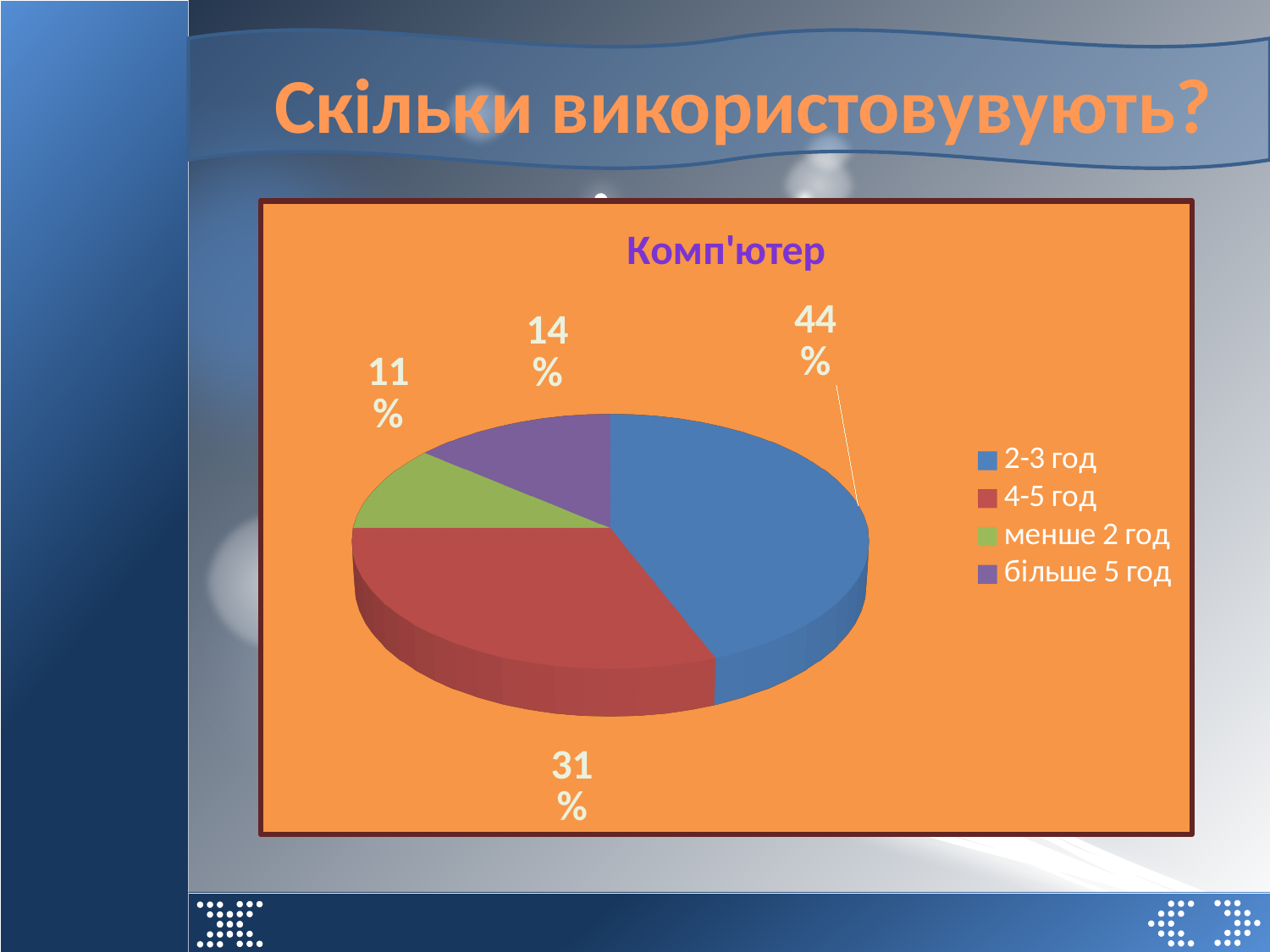
What colour is the '4-5 год' slice? Red What is the title of the chart? Комп'ютер Which category has the smallest slice of the pie? менше 2 год How many categories does the legend list? 4 What share of the pie does the 'більше 5 год' slice represent? 14% What share of the pie does the '4-5 год' slice represent? 31% What is the difference in percentage points between the '2-3 год' and '4-5 год' slices? 13 What share of the pie does the 'менше 2 год' slice represent? 11% Which category has the largest slice of the pie? 2-3 год What type of chart is shown on the slide? Pie chart Which slice is larger: 'більше 5 год' or 'менше 2 год'? більше 5 год